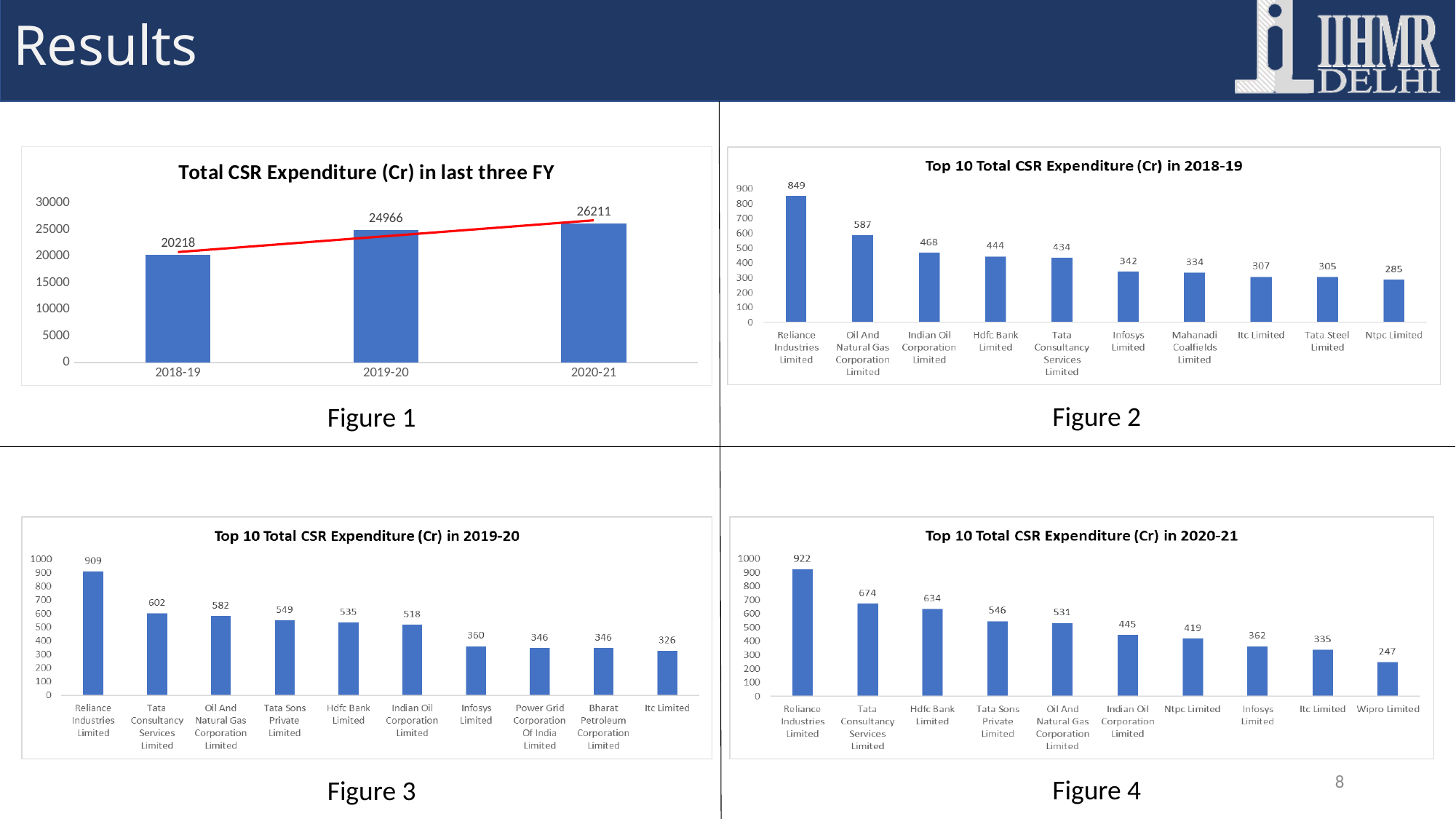
What kind of chart is Figure 4 ('Top 10 Total CSR Expenditure (Cr) in 2020-21')? bar chart In Figure 2 ('Top 10 Total CSR Expenditure (Cr) in 2018-19'), what is the value for Hdfc Bank Limited? 444 In the chart titled 'Top 10 Total CSR Expenditure (Cr) in 2019-20' (Figure 3), what is the value for Tata Sons Private Limited? 549 In the chart titled 'Top 10 Total CSR Expenditure (Cr) in 2020-21' (Figure 4), what is the value for Wipro Limited? 247 In the chart titled 'Total CSR Expenditure (Cr) in last three FY' (Figure 1), what is the value for 2019-20? 24966 In Figure 1 ('Total CSR Expenditure (Cr) in last three FY'), do the values rise or fall from 2018-19 to 2020-21? rise In Figure 3 ('Top 10 Total CSR Expenditure (Cr) in 2019-20'), which is larger: the value for Tata Consultancy Services Limited or Oil And Natural Gas Corporation Limited? Tata Consultancy Services Limited In the chart titled 'Top 10 Total CSR Expenditure (Cr) in 2018-19' (Figure 2), which company has the highest value? Reliance Industries Limited In Figure 2 ('Top 10 Total CSR Expenditure (Cr) in 2018-19'), which company has the lowest value? Ntpc Limited In Figure 3 ('Top 10 Total CSR Expenditure (Cr) in 2019-20'), how many companies are shown? 10 In Figure 4 ('Top 10 Total CSR Expenditure (Cr) in 2020-21'), what is the difference between the values for Reliance Industries Limited and Tata Consultancy Services Limited? 248 In Figure 1 ('Total CSR Expenditure (Cr) in last three FY'), what is the difference between the 2020-21 and 2018-19 values? 5993